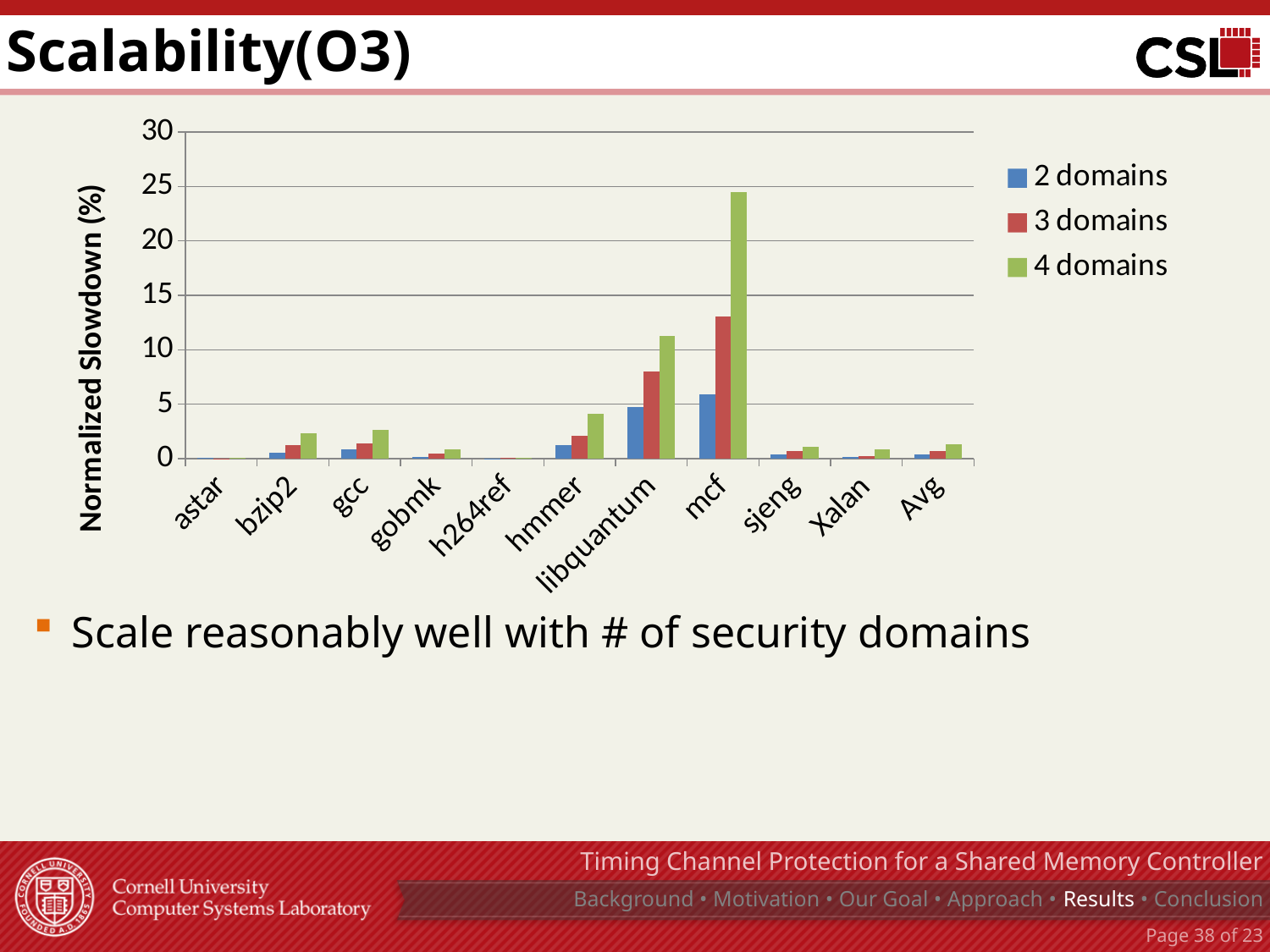
Is the 4 domains value for libquantum greater or less than 10? greater For mcf, which series has the larger value, 2 domains or 4 domains? 4 domains For 4 domains, which has the larger normalized slowdown, mcf or libquantum? mcf What kind of chart is shown on the slide? bar chart Is the 4 domains value for mcf greater or less than 20? greater Which benchmark has the highest normalized slowdown for 4 domains? mcf How many benchmark categories are shown on the x axis of the chart? 11 Is the 3 domains value for mcf greater or less than 10? greater Which colour represents the 4 domains series in the chart legend? green What is the label of the y axis of the chart? Normalized Slowdown (%) How many series does the chart legend list? 3